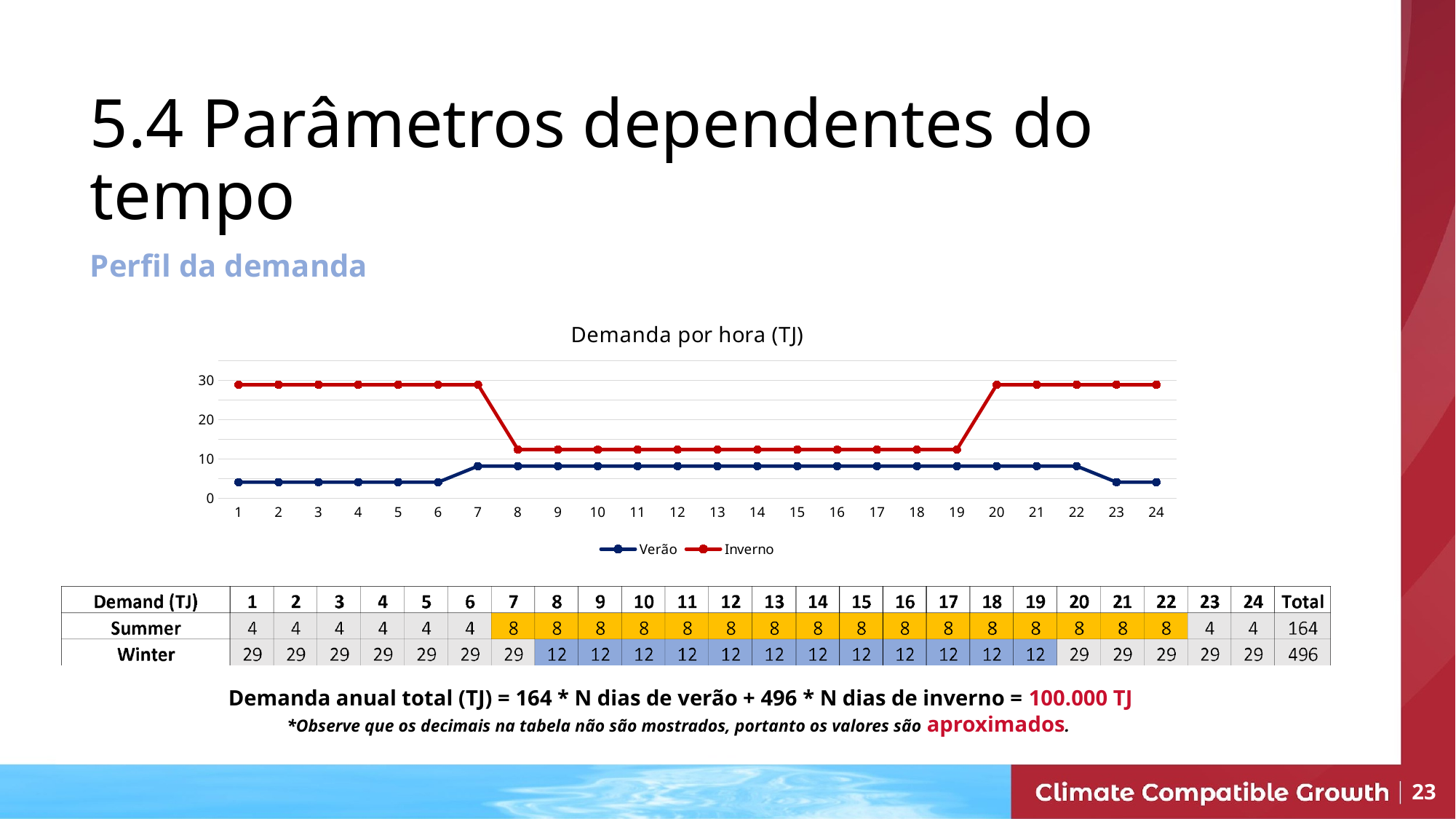
According to the table, what is the difference between the Winter and Summer demand at hour 12? 4 Which series has the higher value at hour 10, Verão or Inverno? Inverno How many series does the legend of the "Demanda por hora (TJ)" chart list? 2 According to the table, what is the Summer demand (TJ) at hour 8? 8 Which series is drawn in red in the "Demanda por hora (TJ)" chart? Inverno According to the table, what is the Total daily demand (TJ) for Winter? 496 Is the Inverno value at hour 3 greater or less than 20? greater Is the Inverno value at hour 12 greater or less than 20? less What kind of chart is shown under the title "Demanda por hora (TJ)"? line chart How many hourly points are plotted along the x axis of the "Demanda por hora (TJ)" chart? 24 According to the table, what is the Winter demand (TJ) at hour 1? 29 Is the Verão value at hour 15 greater or less than 10? less